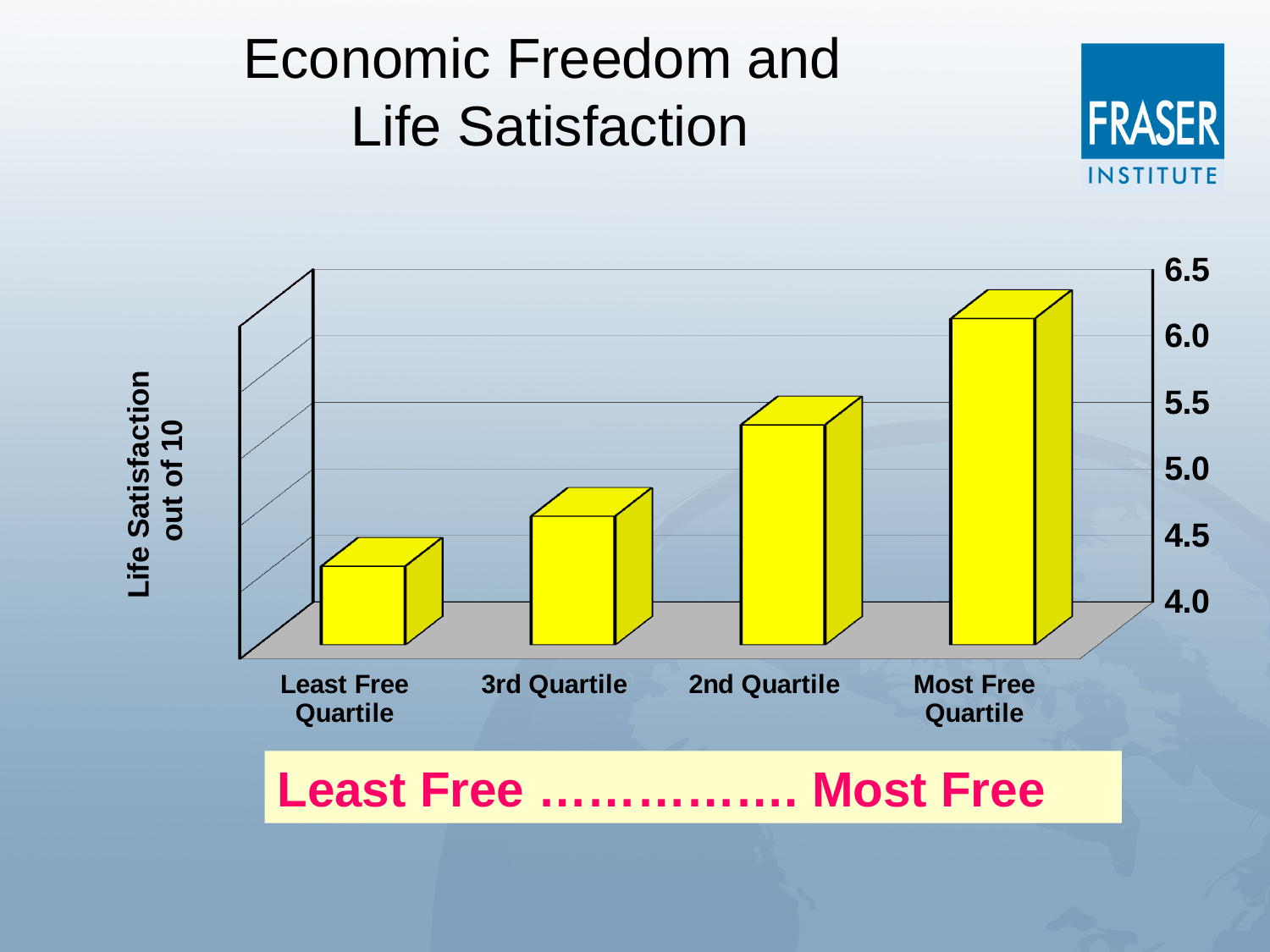
Which has a higher life satisfaction value, the 2nd Quartile or the 3rd Quartile? 2nd Quartile Is the value for the 2nd Quartile greater or less than 5.0? greater How many categories (bars) are plotted in the chart? 4 Which quartile has the lowest life satisfaction in the chart? Least Free Quartile Is the value for the Least Free Quartile greater or less than 5.0? less Is the value for the 3rd Quartile greater or less than 5.5? less What kind of chart is shown on the slide? bar chart What is the label on the vertical axis of the chart? Life Satisfaction out of 10 Which quartile has the highest life satisfaction in the chart? Most Free Quartile What is the title of the chart on the slide? Economic Freedom and Life Satisfaction Do the life satisfaction values rise or fall moving from the Least Free Quartile to the Most Free Quartile? rise